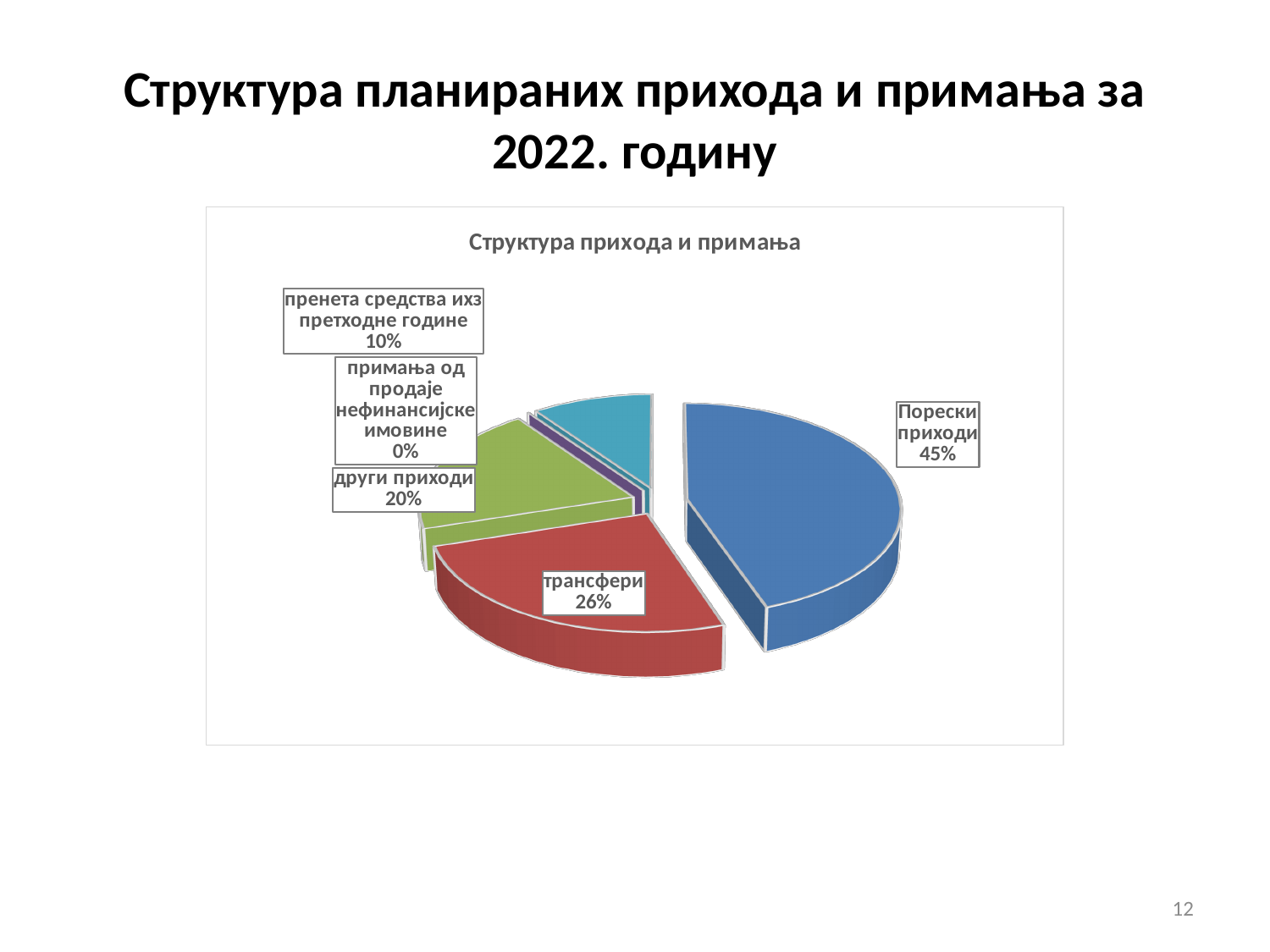
Which is larger, the share for други приходи or the share for пренета средства ихз претходне године? други приходи What share of the pie does примања од продаје нефинансијске имовине have? 0% Which category has the smallest share of the pie? примања од продаје нефинансијске имовине What share of the pie does Порески приходи have? 45% What is the title of the chart? Структура прихода и примања What kind of chart is shown on the slide? pie chart What is the difference in percentage points between Порески приходи and трансфери? 19 What share of the pie does трансфери have? 26% How many categories are shown in the pie chart? 5 Which category has the largest share of the pie? Порески приходи